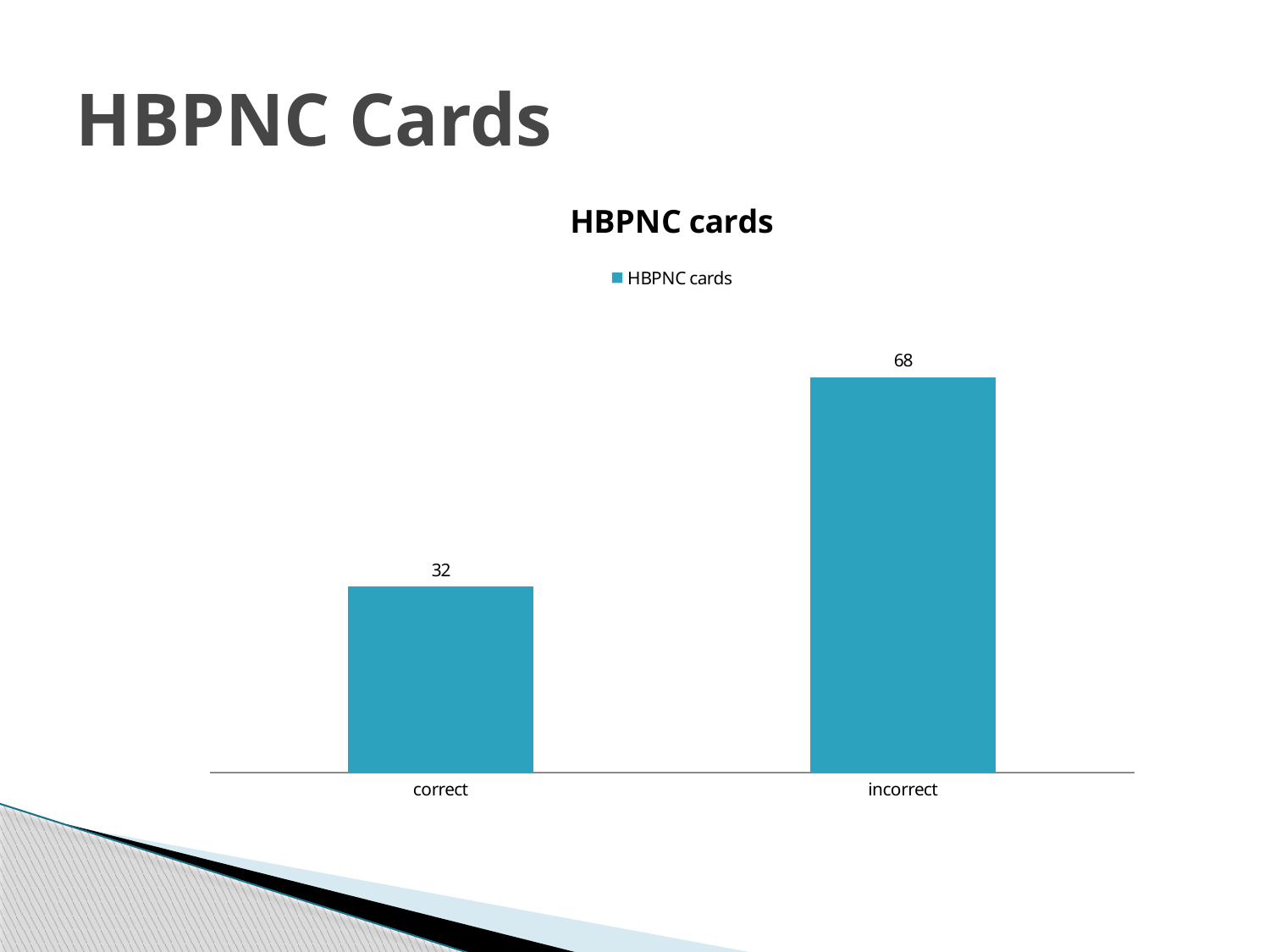
What series name is shown in the legend? HBPNC cards Which is larger, the value for correct or the value for incorrect? incorrect How many categories are shown on the x axis? 2 How many series does the legend list? 1 Which category has the lowest value? correct What is the value for correct? 32 What is the value for incorrect? 68 What kind of chart is shown? bar chart What is the difference between the values for incorrect and correct? 36 What is the title of the chart? HBPNC cards Do the values rise or fall from correct to incorrect? rise Which category has the highest value? incorrect